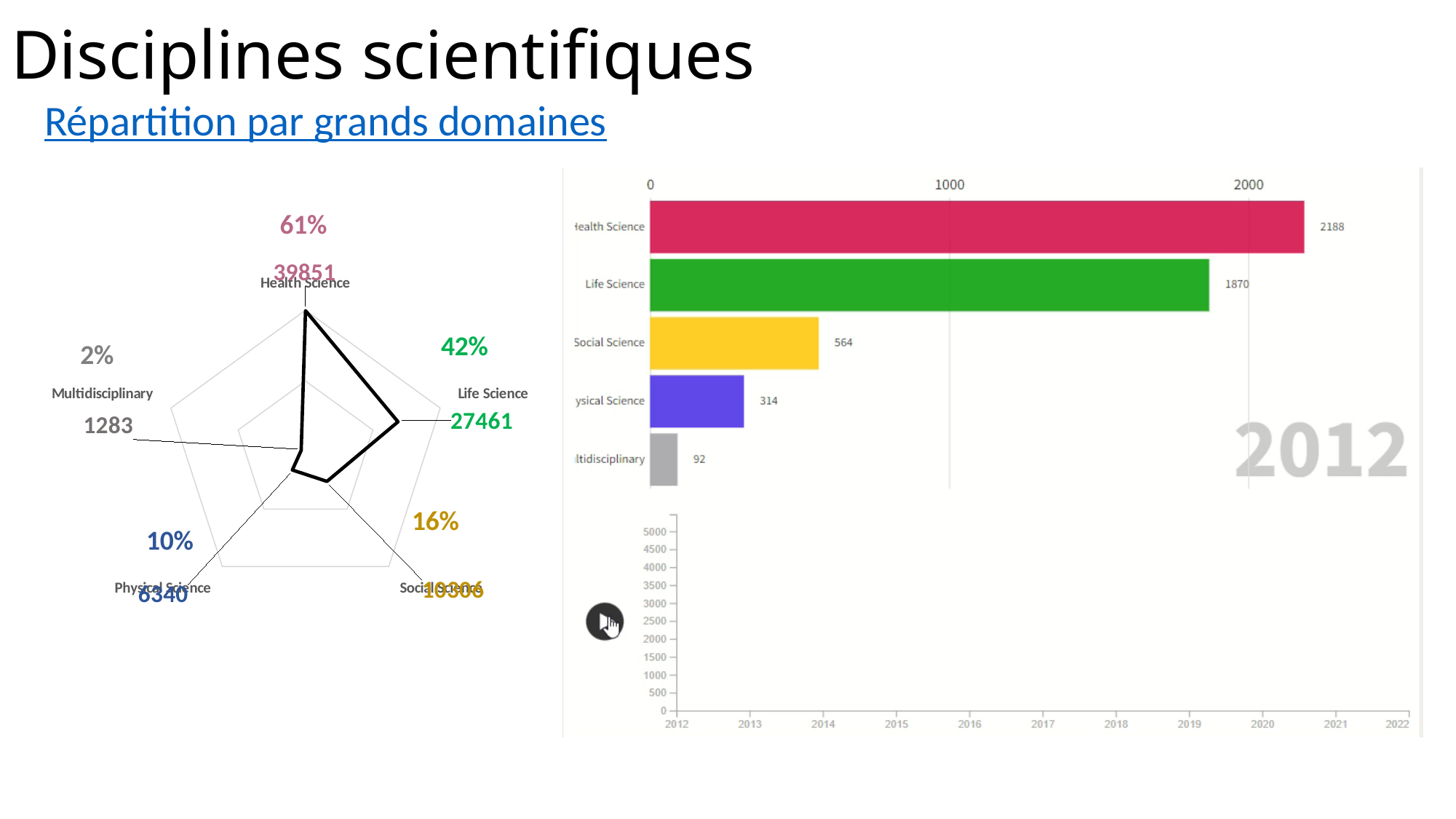
In the bar chart on the right, which category has the lowest value? Multidisciplinary What kind of chart is the chart on the right showing values for 2012? bar chart In the bar chart on the right, what is the value for Social Science? 564 In the bar chart on the right, what is the value for Life Science? 1870 In the radar chart on the left, what value is shown for Health Science? 39851 How many categories are shown in the bar chart on the right? 5 What year is displayed in large text on the bar chart on the right? 2012 In the bar chart on the right, is the value for Physical Science greater or less than 1000? less In the bar chart on the right, what is the difference between the Health Science and Life Science values? 318 In the radar chart on the left, what percentage is shown for Life Science? 42% In the radar chart on the left, which is larger, the value for Physical Science or the value for Social Science? Social Science In the bar chart on the right, which category has the highest value? Health Science